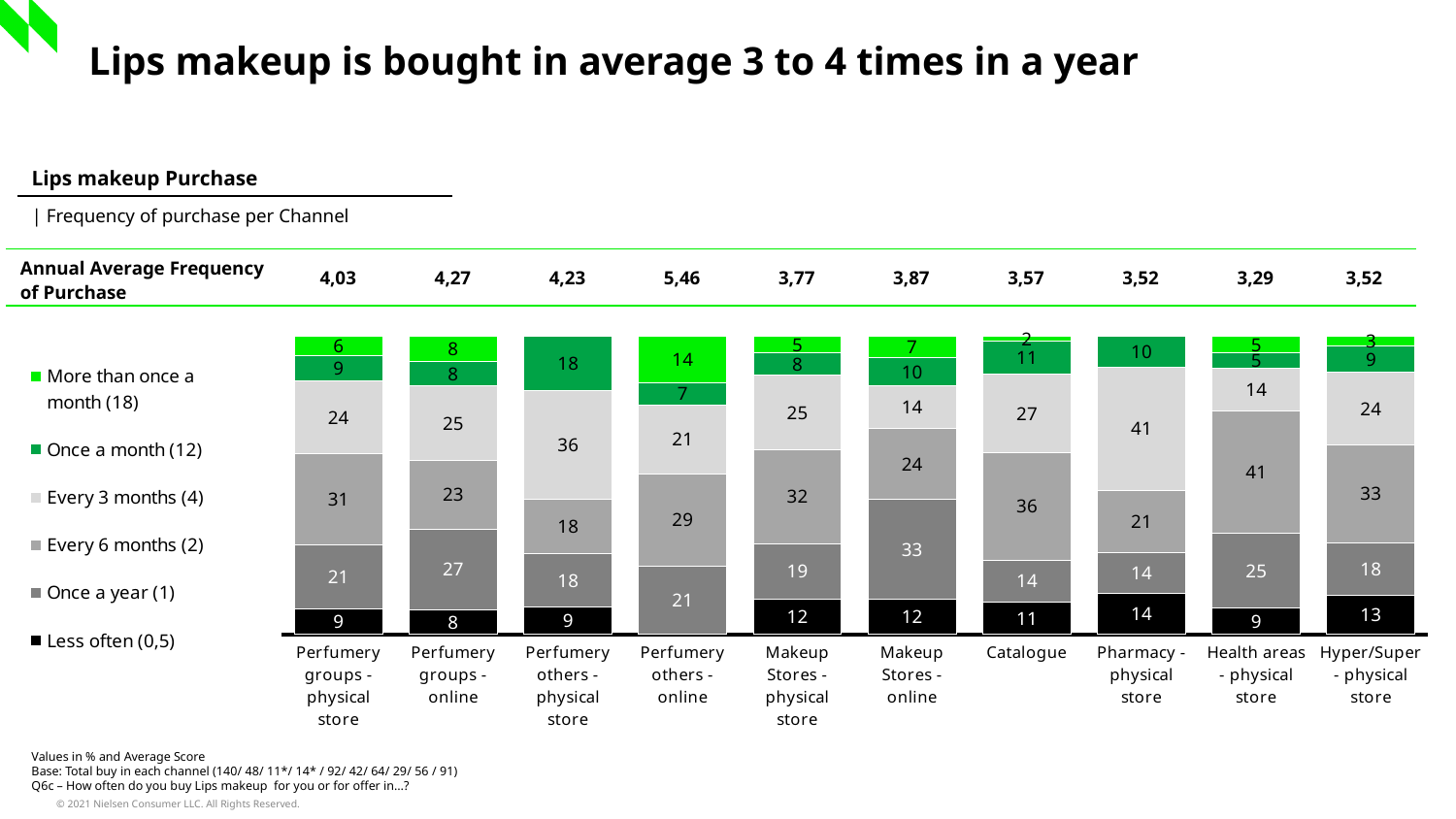
Which channel has the highest 'Once a year (1)' value? Makeup Stores - online How many series does the legend list? 6 How many channels (bars) are shown in the chart? 10 What is the difference between the 'Once a year (1)' values for Perfumery groups - online and Perfumery groups - physical store? 6 What is the 'Every 6 months (2)' value for Catalogue? 36 What is the total of the stacked bar for Perfumery groups - physical store? 100 Which has the larger 'Less often (0,5)' value: Hyper/Super - physical store or Health areas - physical store? Hyper/Super - physical store What is the Annual Average Frequency of Purchase shown for Perfumery others - online? 5,46 What is the 'Once a year (1)' value for Makeup Stores - online? 33 What kind of chart is shown on the slide? Stacked bar chart Which channel has the highest 'Every 6 months (2)' value? Health areas - physical store What is the 'Every 3 months (4)' value for Pharmacy - physical store? 41